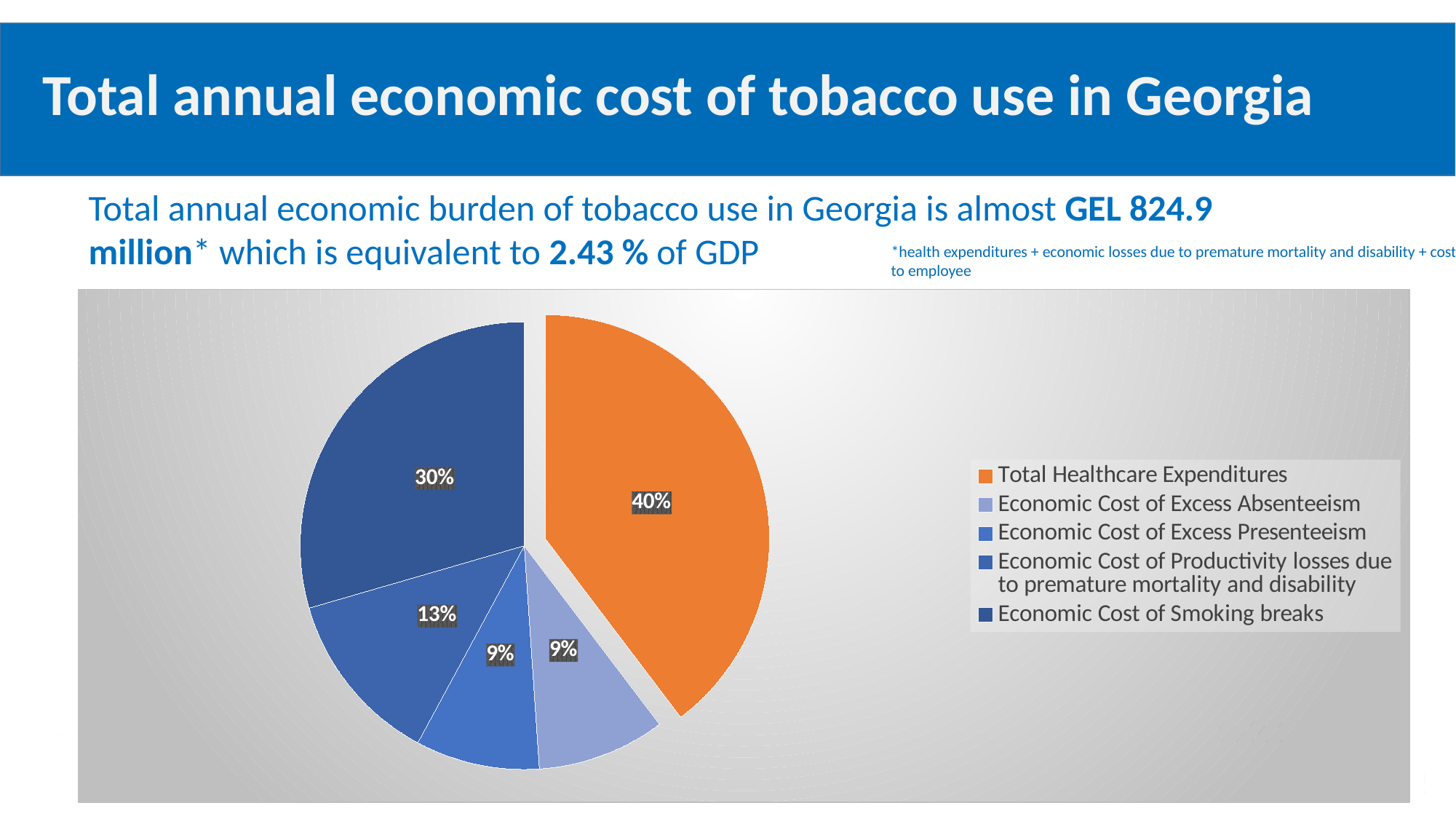
What share of the pie is Economic Cost of Smoking breaks? 30% What share of the pie is Economic Cost of Productivity losses due to premature mortality and disability? 13% How many entries does the legend list? 5 Which is larger, Economic Cost of Smoking breaks or Economic Cost of Productivity losses due to premature mortality and disability? Economic Cost of Smoking breaks What colour is the Total Healthcare Expenditures slice? orange What is the difference in percentage points between Total Healthcare Expenditures and Economic Cost of Smoking breaks? 10 How many slices does the pie chart have? 5 Which category has the largest slice of the pie? Total Healthcare Expenditures What is the combined share of Economic Cost of Excess Absenteeism and Economic Cost of Excess Presenteeism? 18% What share of the pie is Economic Cost of Excess Absenteeism? 9% What share of the pie is Total Healthcare Expenditures? 40% What kind of chart is shown on the slide? pie chart